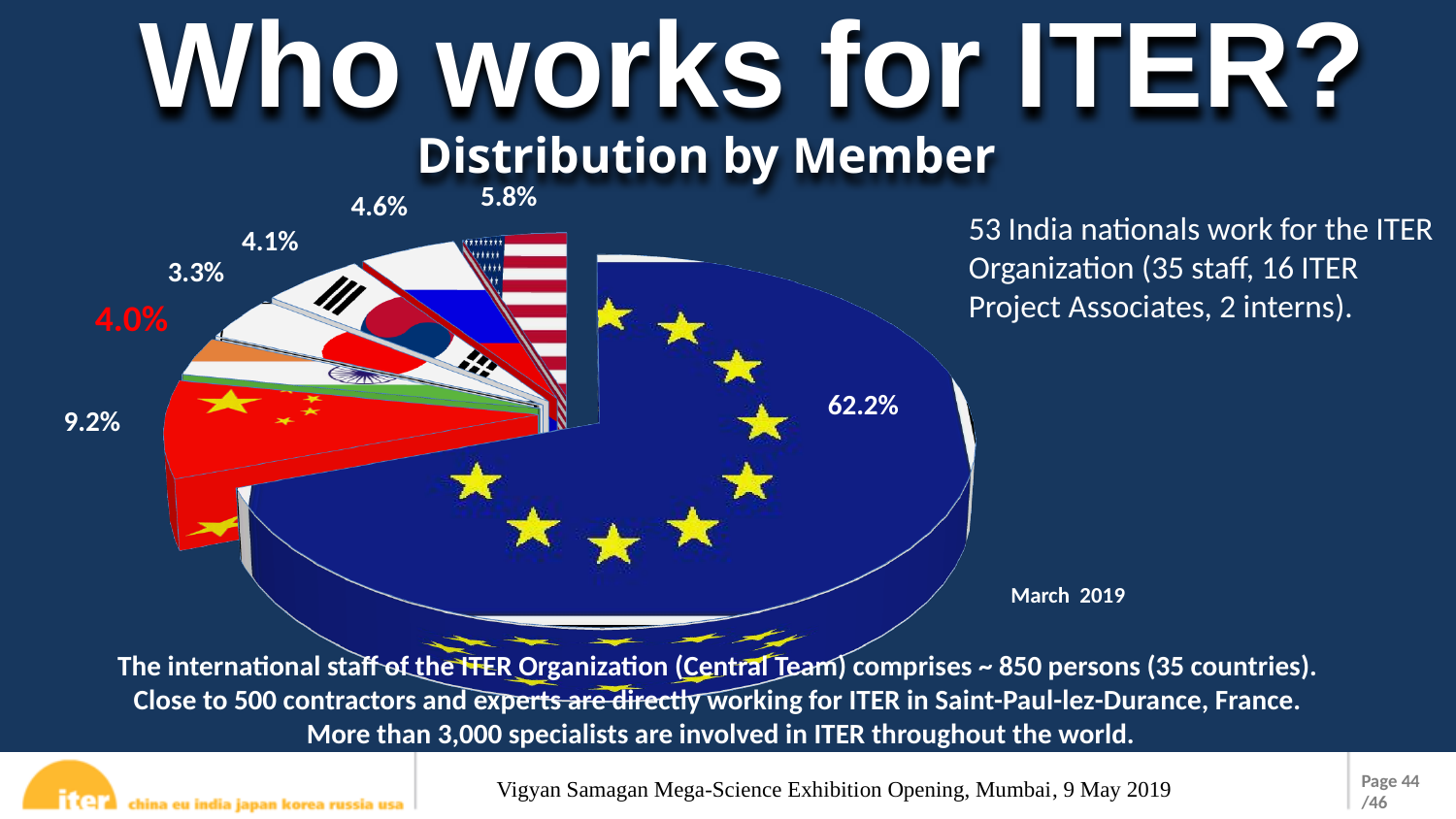
What is the title of the chart? Distribution by Member Which is larger, the 5.8% slice or the 4.6% slice? 5.8% Which percentage label on the pie chart is printed in red? 4.0% What is the difference between the largest slice (62.2%) and the second largest slice (9.2%)? 53.0% What share is shown for the slice with the EU flag? 62.2% What is the smallest percentage labelled on the pie chart? 3.3% What date is printed next to the pie chart? March 2019 Is the largest slice of the pie greater or less than 50%? greater What share is shown for the slice with the Chinese flag? 9.2% What is the largest percentage shown on the pie chart? 62.2% What kind of chart is shown on the slide? pie chart